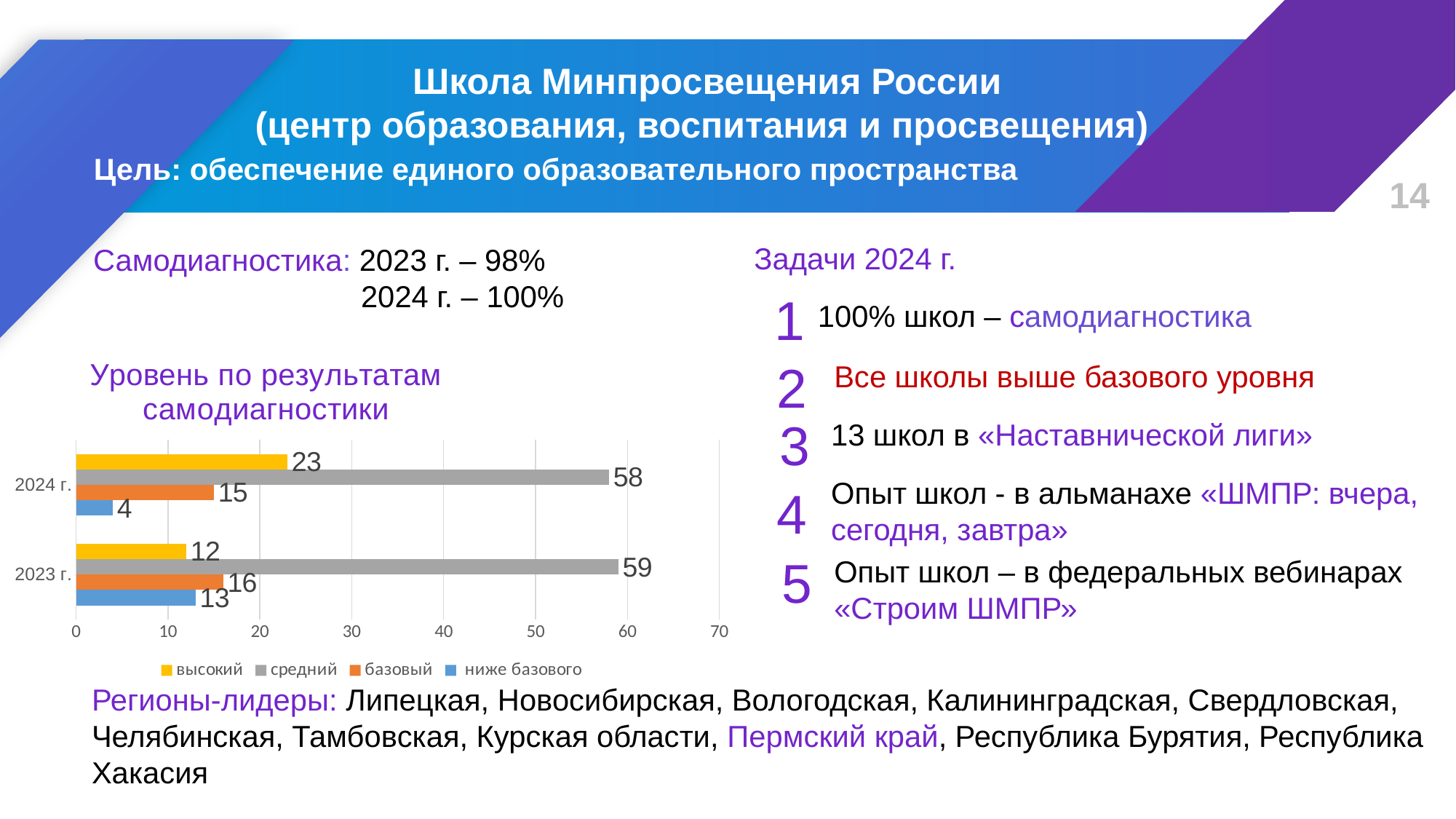
What type of chart is shown on the slide? bar chart What is the difference between the «высокий» values for 2024 г. and 2023 г.? 11 What is the value for «высокий» in 2024 г.? 23 How many series does the legend list? 4 Which is larger: «ниже базового» in 2023 г. or «ниже базового» in 2024 г.? 2023 г. Which series has the lowest value in 2023 г.? высокий What is the title of the chart? Уровень по результатам самодиагностики What is the value for «средний» in 2023 г.? 59 How many categories (years) are shown on the chart? 2 What is the value for «ниже базового» in 2024 г.? 4 Which series has the highest value in 2024 г.? средний What is the value for «базовый» in 2023 г.? 16